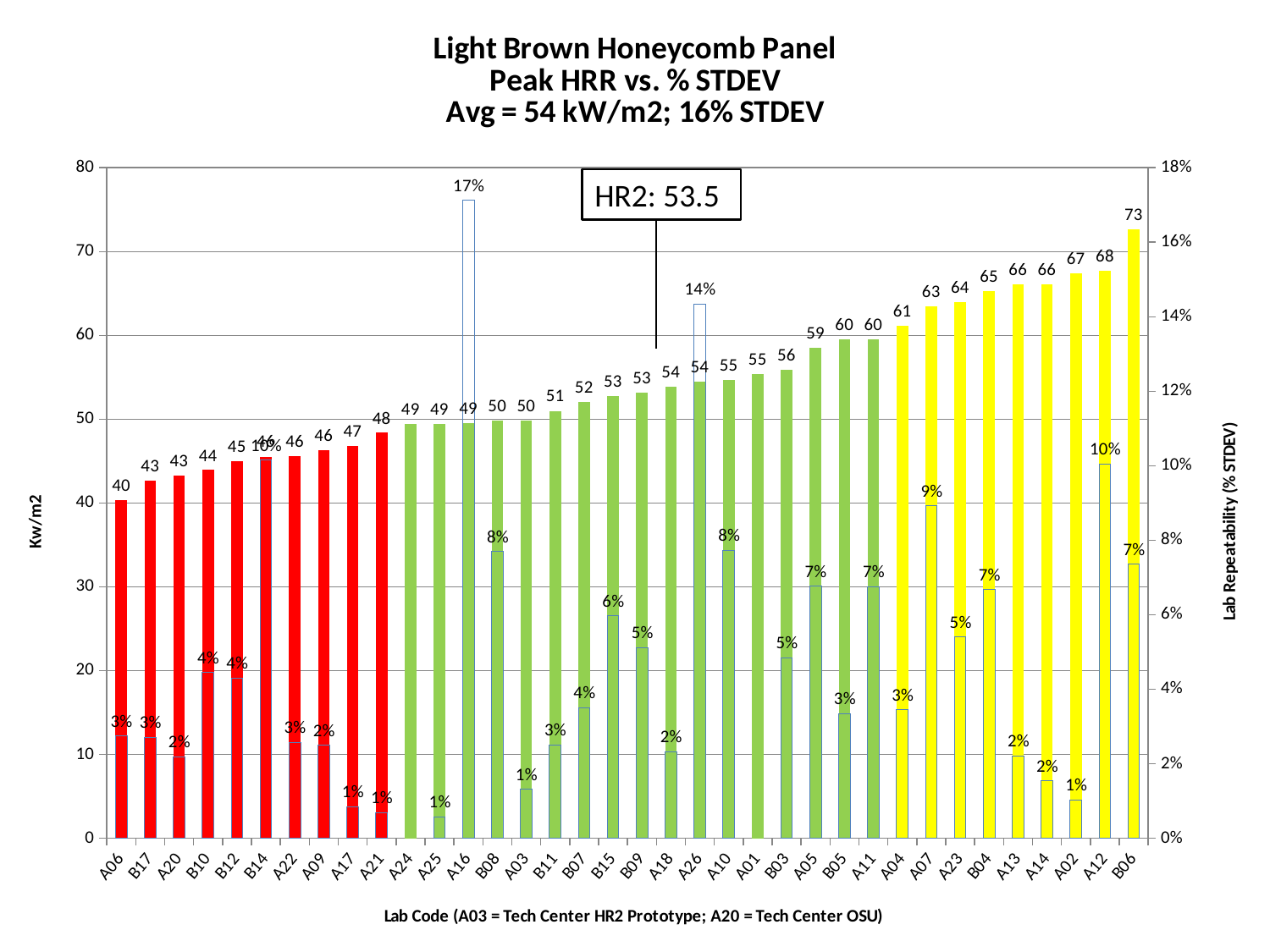
Is the peak HRR value for A05 greater or less than 50? greater Which lab code has the highest peak HRR? B06 What kind of chart is this? bar chart Do the peak HRR values rise or fall from left to right along the x axis? rise What is the difference in peak HRR between B06 and A06? 33 Which lab code has the lowest peak HRR? A06 What is the peak HRR value for lab B06? 73 How many lab codes are shown on the x axis? 36 What is the lab repeatability (% STDEV) for lab A16? 17% What value is shown in the HR2 annotation box on the chart? 53.5 Which lab has the higher peak HRR, A07 or A04? A07 What is the lab repeatability (% STDEV) for lab A12? 10%